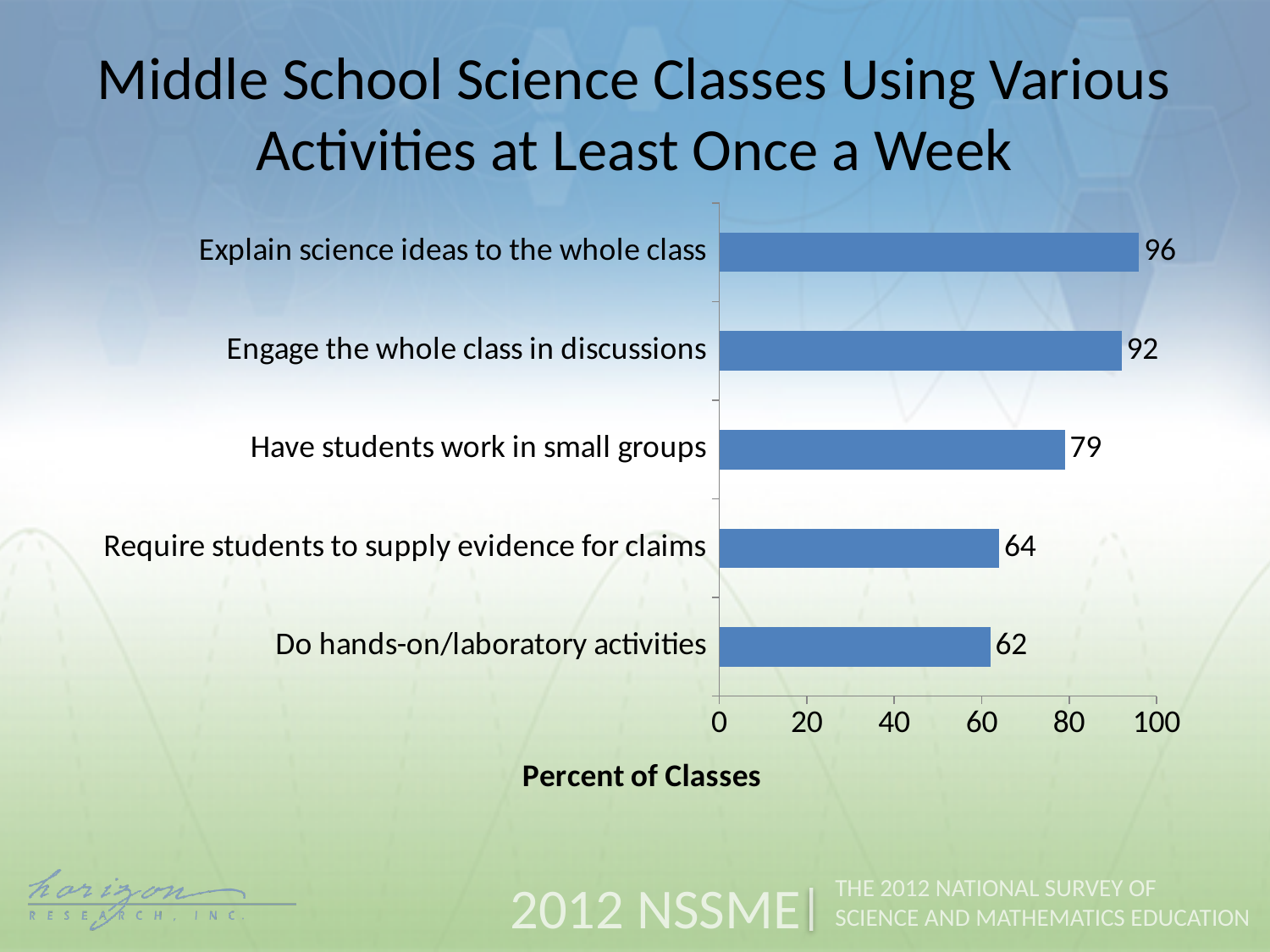
How many activities are shown in the chart? 5 What is the difference between 'Engage the whole class in discussions' and 'Require students to supply evidence for claims'? 28 What kind of chart is shown on the slide? Bar chart Is the value for 'Engage the whole class in discussions' greater or less than 80? greater What is the label of the horizontal axis? Percent of Classes What is the maximum value shown on the horizontal axis? 100 What percent of classes explain science ideas to the whole class at least once a week? 96 What is the value for 'Have students work in small groups'? 79 Which is larger: 'Have students work in small groups' or 'Require students to supply evidence for claims'? Have students work in small groups What is the value for 'Do hands-on/laboratory activities'? 62 Which activity has the lowest percent of classes? Do hands-on/laboratory activities Which activity has the highest percent of classes? Explain science ideas to the whole class